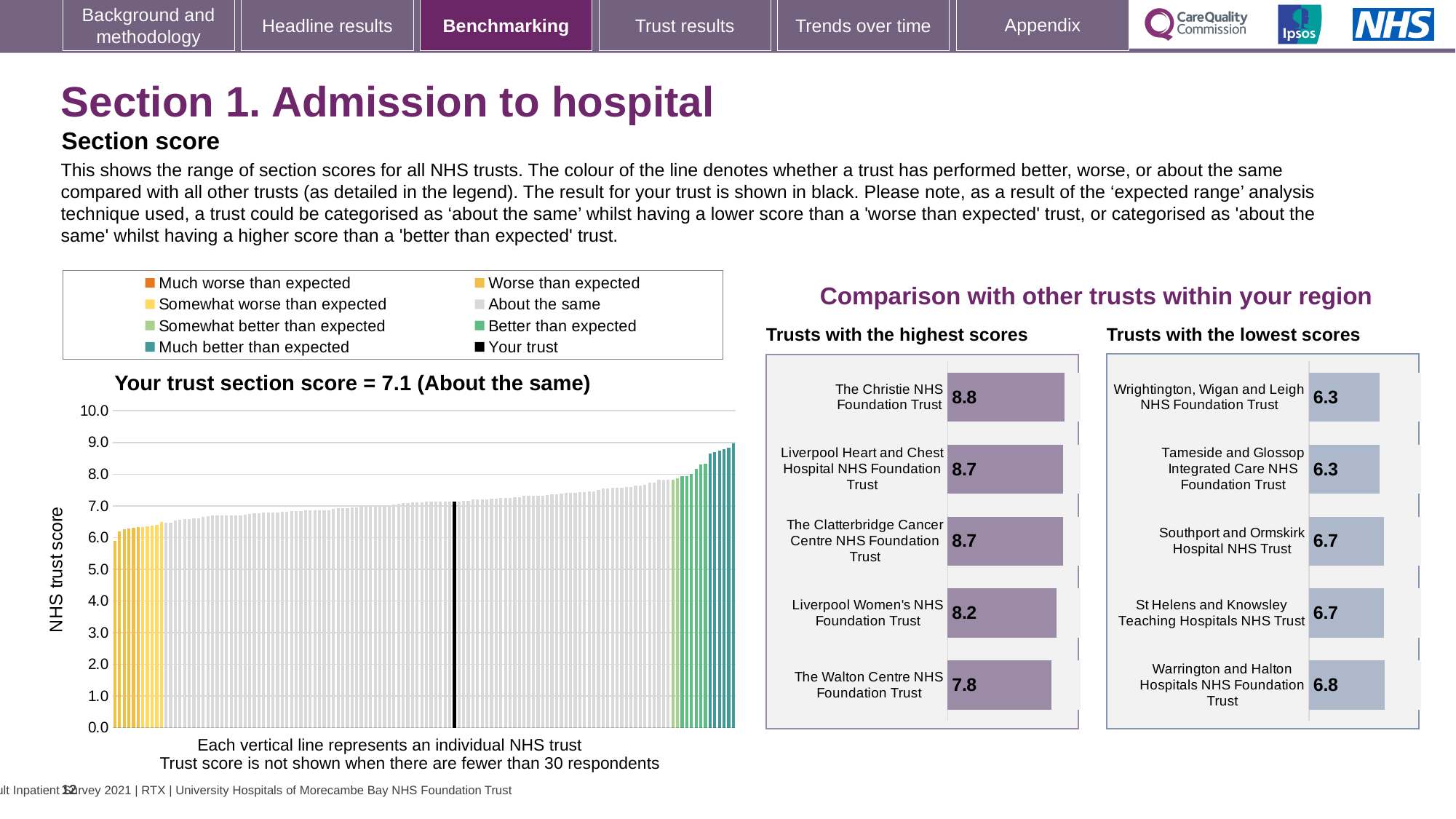
On the 'Trusts with the lowest scores' chart, which has the larger score: St Helens and Knowsley Teaching Hospitals NHS Trust or Wrightington, Wigan and Leigh NHS Foundation Trust? St Helens and Knowsley Teaching Hospitals NHS Trust On the 'Trusts with the highest scores' chart, what is the difference between the scores of The Christie NHS Foundation Trust and The Walton Centre NHS Foundation Trust? 1.0 On the 'Trusts with the highest scores' chart, which trust has the lowest score? The Walton Centre NHS Foundation Trust On the 'Your trust section score' chart, what is the section score for your trust? 7.1 On the 'Your trust section score' chart, what is the label on the vertical axis? NHS trust score On the 'Trusts with the highest scores' chart, what is the score for The Christie NHS Foundation Trust? 8.8 How many entries does the legend above the 'Your trust section score' chart list? 8 How many trusts are shown on the 'Trusts with the highest scores' chart? 5 On the 'Trusts with the lowest scores' chart, what is the score for Southport and Ormskirk Hospital NHS Trust? 6.7 On the 'Trusts with the lowest scores' chart, which trust has the highest score? Warrington and Halton Hospitals NHS Foundation Trust On the 'Your trust section score' chart, do the bars rise or fall from left to right? rise What kind of chart is the 'Your trust section score' chart? bar chart